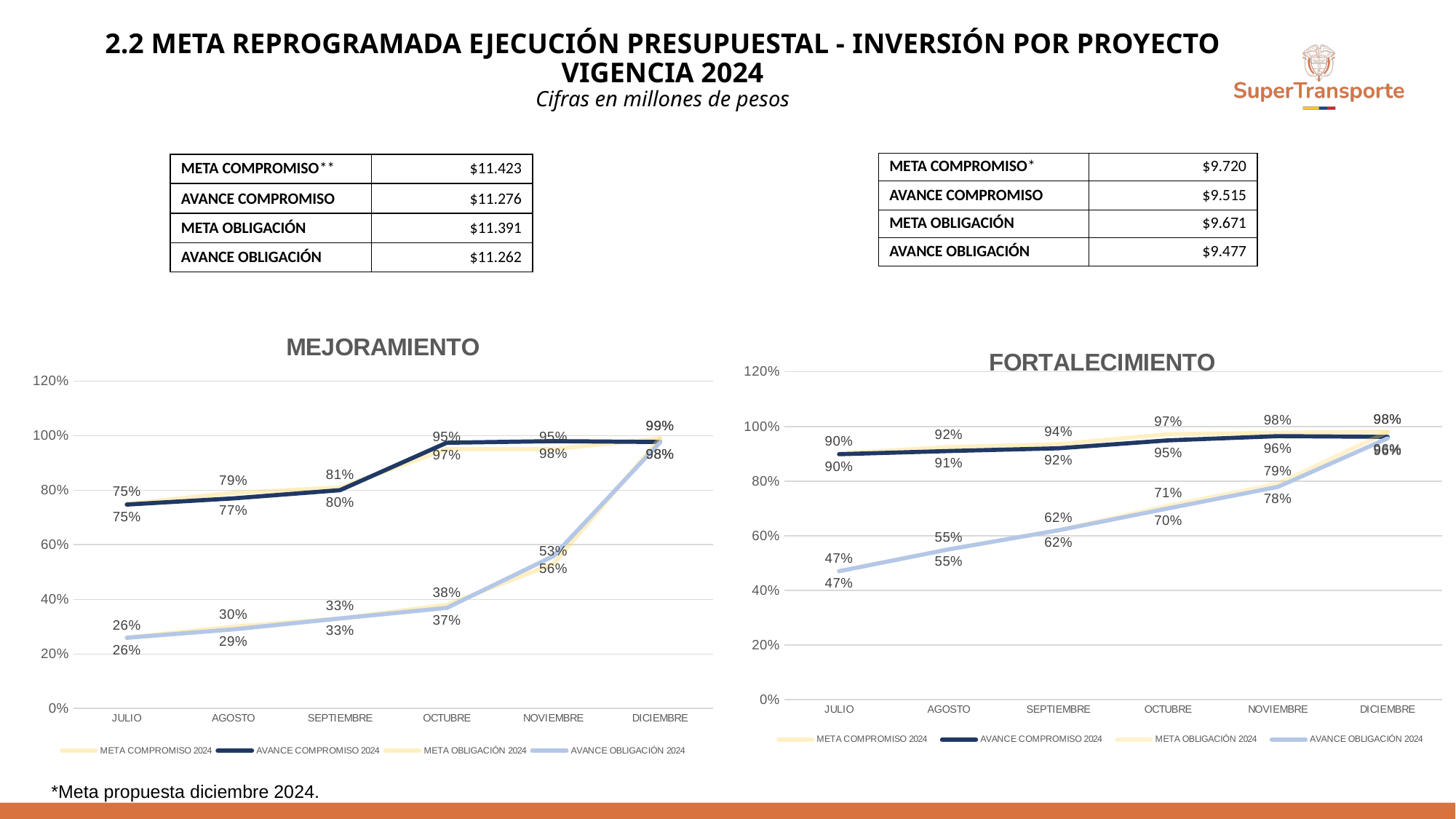
In the MEJORAMIENTO chart, which is larger for AVANCE OBLIGACIÓN 2024: OCTUBRE or NOVIEMBRE? NOVIEMBRE In the FORTALECIMIENTO chart, what is the value for AVANCE COMPROMISO 2024 in JULIO? 90% How many months are shown on the x axis of the MEJORAMIENTO chart? 6 In the FORTALECIMIENTO chart, what is the value for AVANCE OBLIGACIÓN 2024 in AGOSTO? 55% In the MEJORAMIENTO chart, is the value for AVANCE OBLIGACIÓN 2024 in OCTUBRE greater or less than 40%? less How many series does the legend of the FORTALECIMIENTO chart list? 4 In the FORTALECIMIENTO chart, what is the value for AVANCE OBLIGACIÓN 2024 in JULIO? 47% In the MEJORAMIENTO chart, what is the value for AVANCE OBLIGACIÓN 2024 in JULIO? 26% In the FORTALECIMIENTO chart, does the AVANCE OBLIGACIÓN 2024 line rise or fall from JULIO to DICIEMBRE? rise In the FORTALECIMIENTO chart, by how many percentage points does AVANCE OBLIGACIÓN 2024 increase from JULIO to AGOSTO? 8 percentage points In the MEJORAMIENTO chart, in which month is AVANCE OBLIGACIÓN 2024 lowest? JULIO What type of chart is the MEJORAMIENTO chart? Line chart